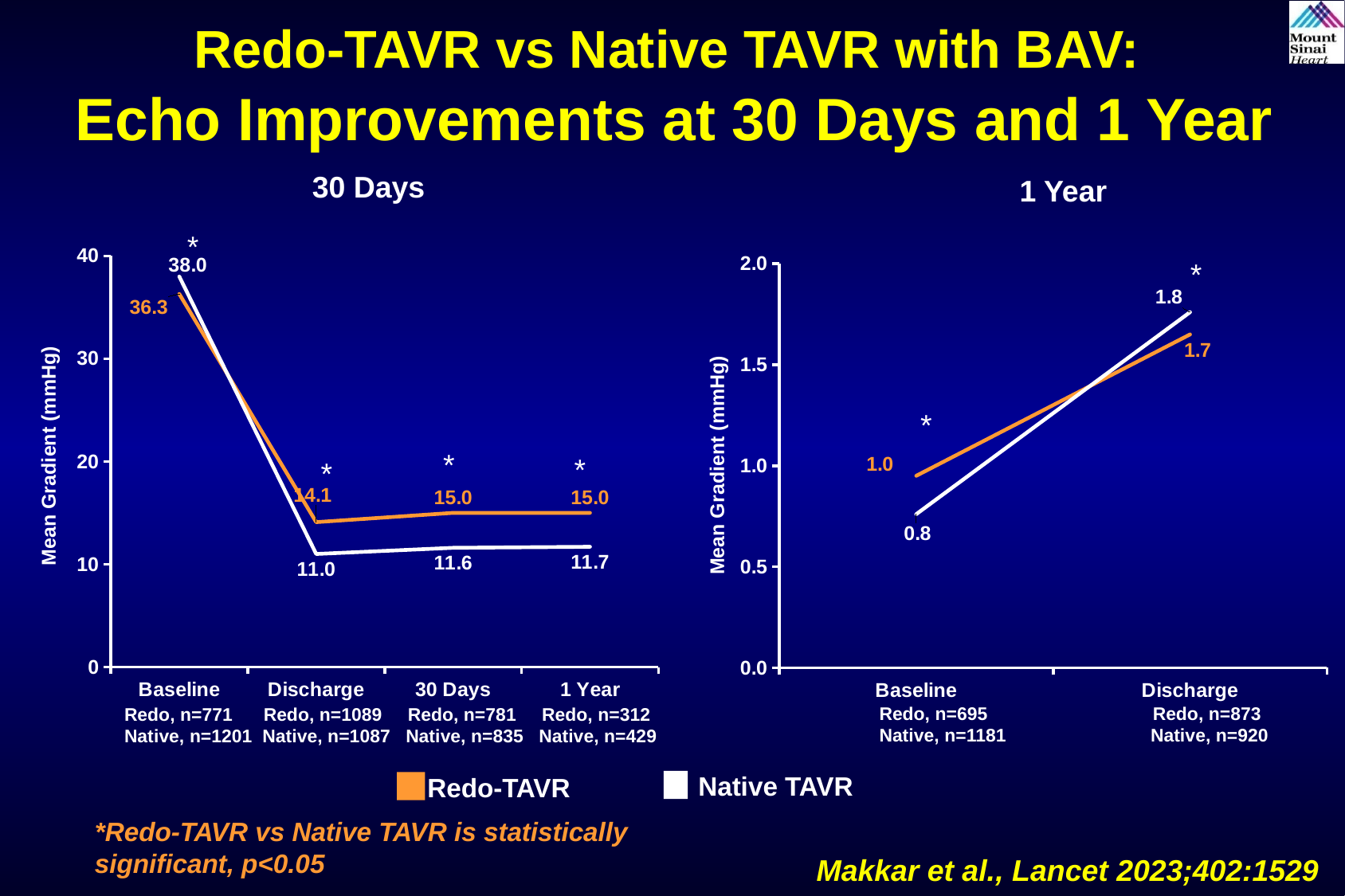
In the left chart (30 Days), at which time point is the Redo-TAVR mean gradient highest? Baseline How many series does the legend list? 2 In the left chart (30 Days), what is the Native TAVR mean gradient at 1 Year? 11.7 In the left chart (30 Days), at which time point is the Native TAVR mean gradient lowest? Discharge In the left chart (30 Days), how many time points are shown on the x axis? 4 In the left chart (30 Days), what is the difference between the Redo-TAVR and Native TAVR mean gradients at 30 Days? 3.4 In the right chart (1 Year), do the values rise or fall from Baseline to Discharge? rise In the left chart (30 Days), what is the Native TAVR mean gradient at Baseline? 38.0 In the left chart (30 Days), what is the Redo-TAVR mean gradient at Discharge? 14.1 In the right chart (1 Year), what is the Native TAVR mean gradient at Discharge? 1.8 In the right chart (1 Year), which series has the larger value at Discharge, Redo-TAVR or Native TAVR? Native TAVR In the right chart (1 Year), what is the Redo-TAVR mean gradient at Baseline? 1.0